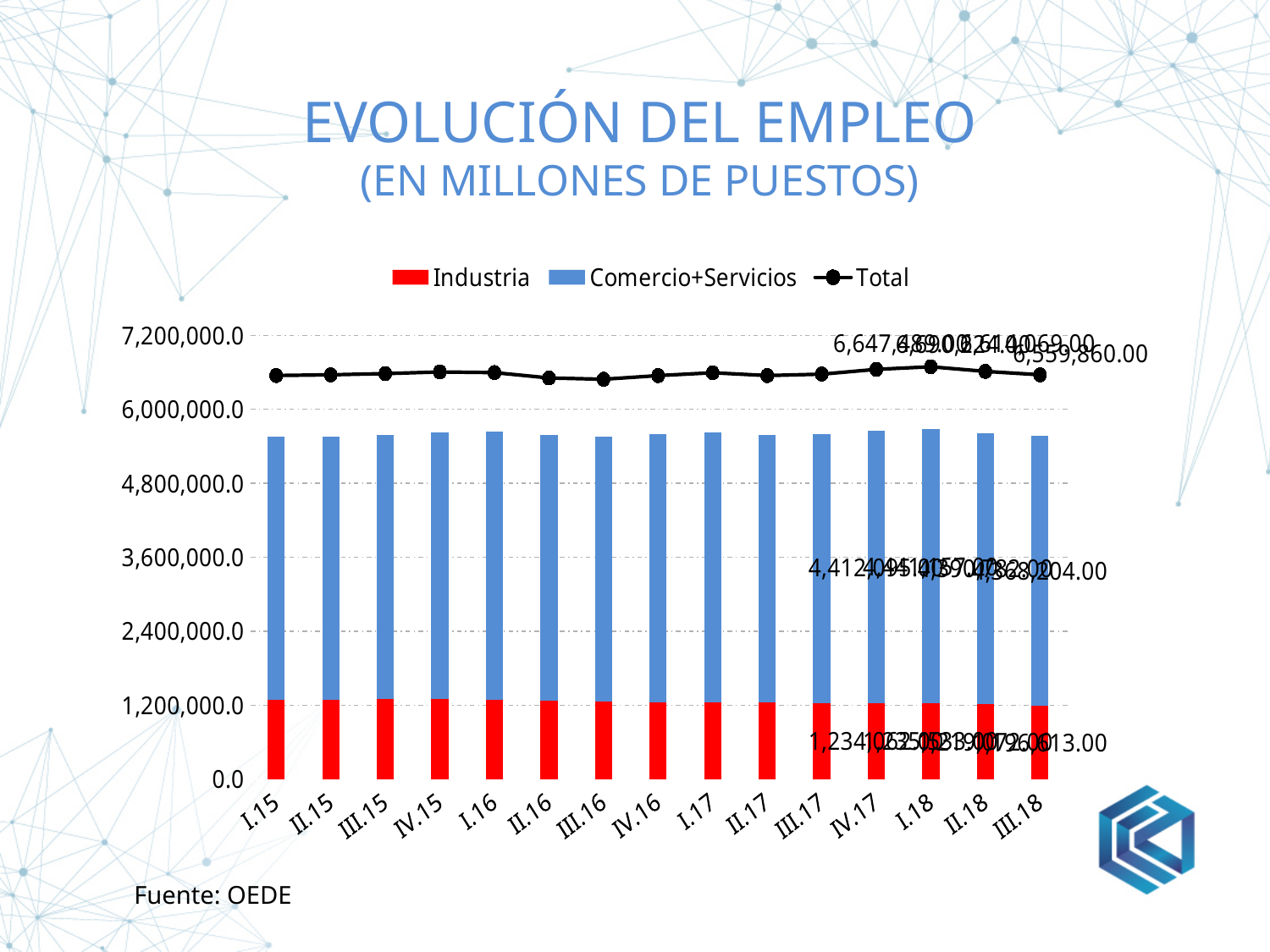
What is the title of the chart on the slide? EVOLUCIÓN DEL EMPLEO (EN MILLONES DE PUESTOS) Is the Total value for I.15 greater or less than 6,000,000.0? greater Is the top of the stacked bar for II.17 greater or less than 4,800,000.0? greater What is the Total value labelled for III.18? 6,559,860.00 Is the Total value for I.18 greater or less than 7,200,000.0? less Which colour represents the Industria series? Red How many categories (quarters) are shown on the x axis of the chart? 15 What kind of chart is shown on the slide? Stacked bar chart with a line What is the first category on the x axis? I.15 How many series does the chart legend list? 3 Which series is larger in every bar, Industria or Comercio+Servicios? Comercio+Servicios